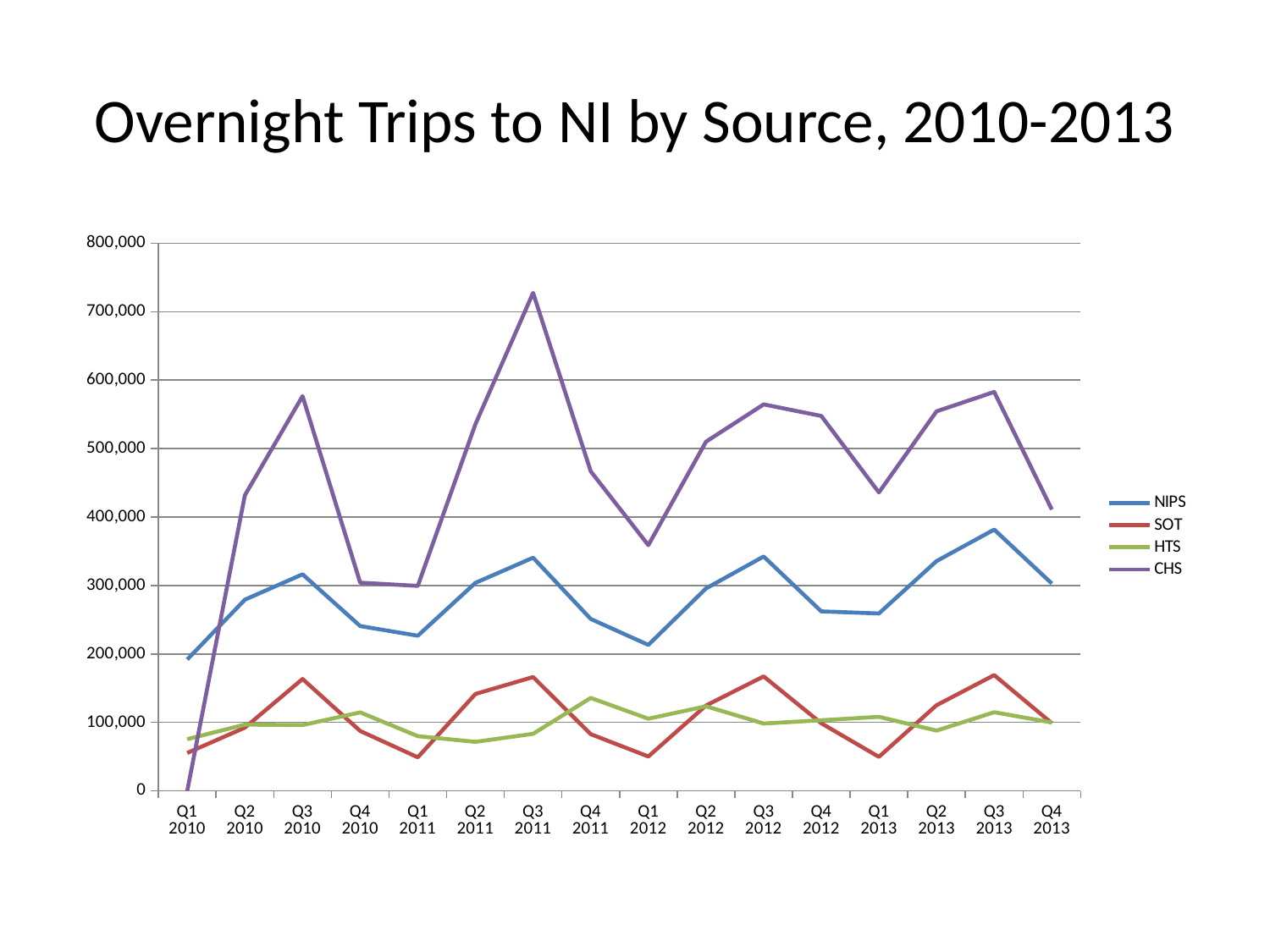
Does the CHS series rise or fall from Q1 2012 to Q3 2012? Rise In which quarter does the CHS series reach its highest value? Q3 2011 What kind of chart is shown on the slide? Line chart Is the value for SOT in Q1 2012 greater or less than 100,000? less Which is larger in Q3 2011, SOT or HTS? SOT How many series does the legend list? 4 Is the value for CHS in Q1 2012 greater or less than 400,000? less Is the value for CHS in Q3 2011 greater or less than 700,000? greater How many quarters are plotted along the x axis? 16 In which quarter does the NIPS series reach its highest value? Q3 2013 What is the title of the chart? Overnight Trips to NI by Source, 2010-2013 Which series reaches the highest value on the chart? CHS